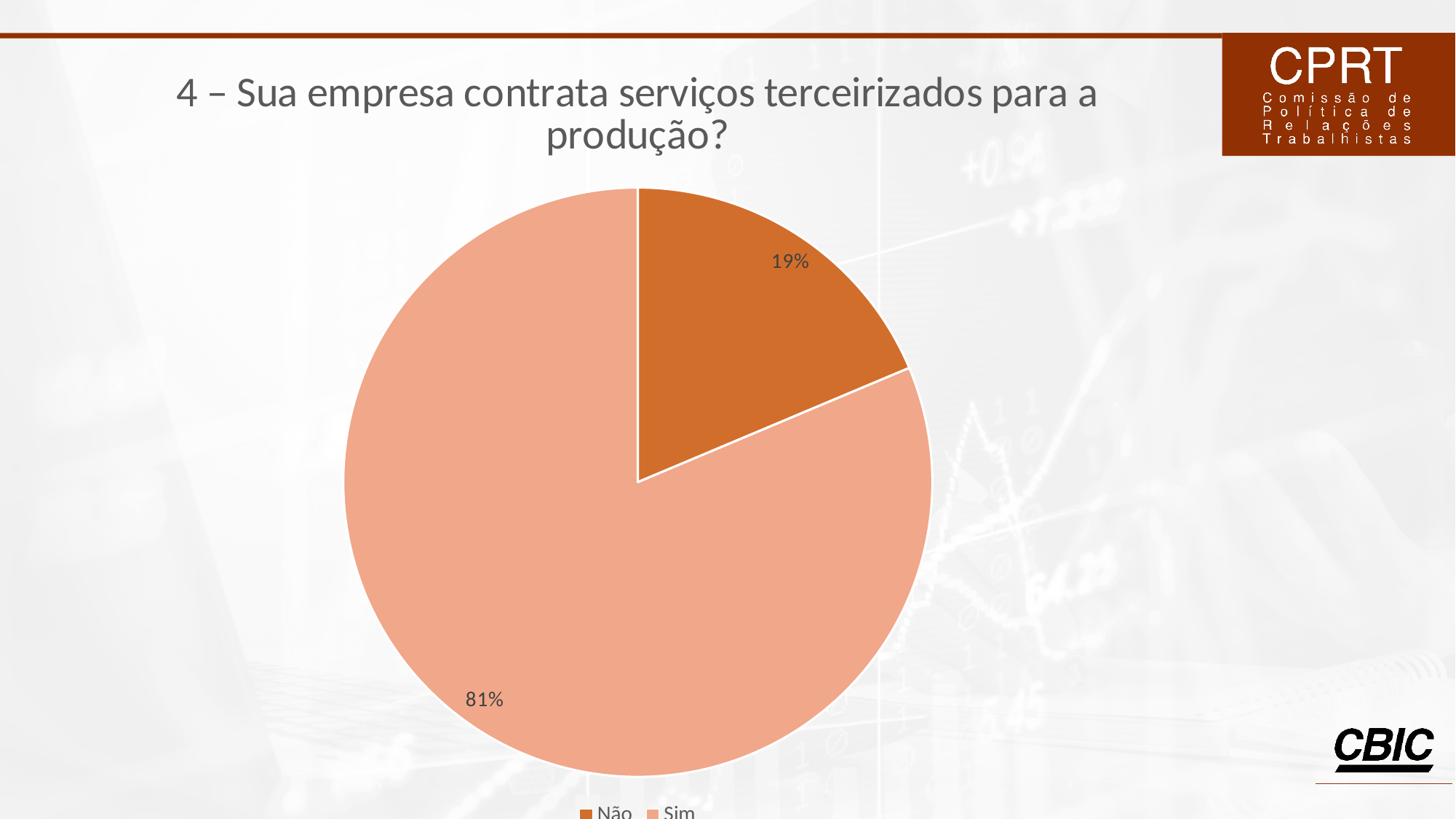
What kind of chart is shown on the slide? Pie chart Which response has the smallest share of the pie? Não What is the difference in percentage points between the "Sim" and "Não" slices? 62 Which response has the largest share of the pie? Sim How many slices does the pie chart have? 2 Which slice is larger, "Sim" or "Não"? Sim What percentage of respondents answered "Sim"? 81% Which legend entry is shown in the darker orange colour? Não What percentage of respondents answered "Não"? 19% How many entries does the legend list? 2 What is the title of the chart? 4 – Sua empresa contrata serviços terceirizados para a produção? What share of the pie does the "Não" slice represent? 19%